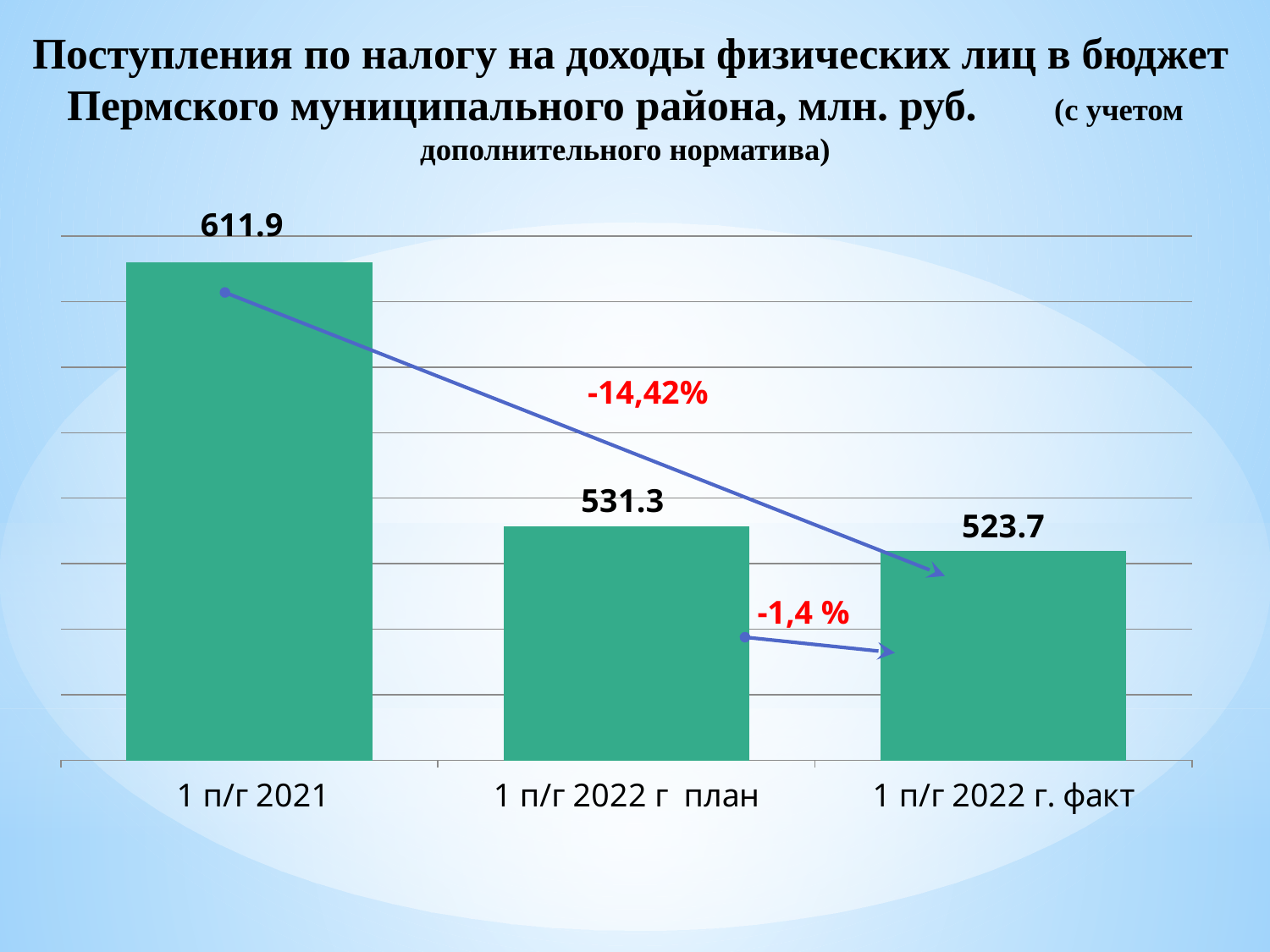
What is the value for 1 п/г 2022 г план? 531.3 What is the value for 1 п/г 2021? 611.9 What is the value for 1 п/г 2022 г. факт? 523.7 Which is larger, the value for 1 п/г 2021 or the value for 1 п/г 2022 г план? 1 п/г 2021 What is the difference between the values for 1 п/г 2022 г план and 1 п/г 2022 г. факт? 7.6 Which category has the highest value? 1 п/г 2021 Which category has the lowest value? 1 п/г 2022 г. факт What percentage change is annotated between 1 п/г 2021 and 1 п/г 2022 г. факт? -14,42% What kind of chart is shown on the slide? bar chart Do the values rise or fall from left to right along the x axis? fall What is the difference between the values for 1 п/г 2021 and 1 п/г 2022 г. факт? 88.2 How many categories are shown in the chart? 3